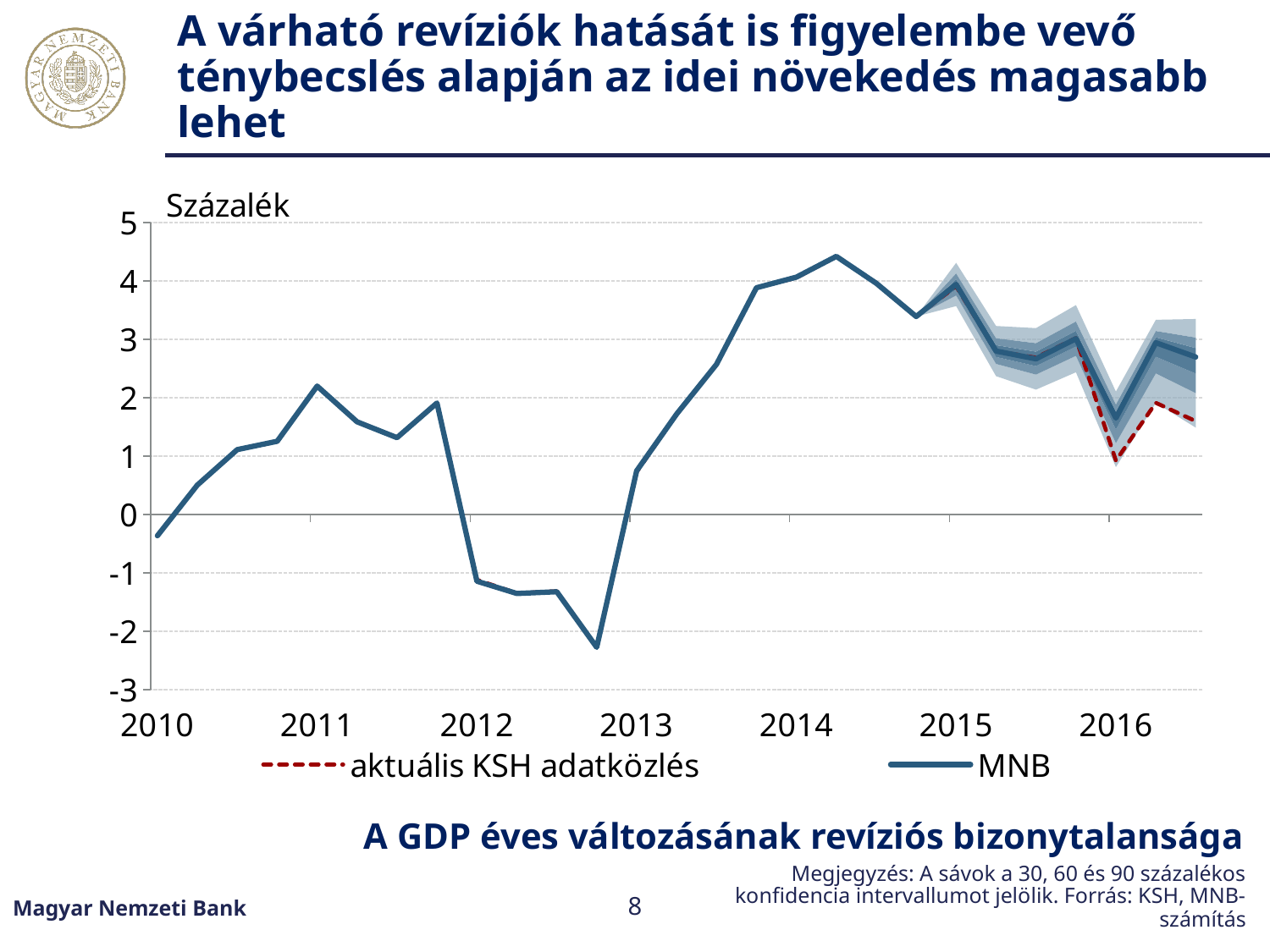
Is the MNB value at the start of 2010 greater or less than 0? less Is the highest MNB value in 2014 greater or less than 4? greater Is the aktuális KSH adatközlés value at the start of 2016 greater or less than 2? less At the start of 2016, which series shows the higher value, MNB or aktuális KSH adatközlés? MNB Does the MNB line rise or fall between the start of 2013 and the start of 2014? rise What are the two series named in the legend? aktuális KSH adatközlés, MNB What kind of chart is shown on the slide? line chart How many series does the legend list? 2 Which is higher, the MNB peak in 2011 or the MNB peak in 2014? the 2014 peak What is the title of the chart? A GDP éves változásának revíziós bizonytalansága